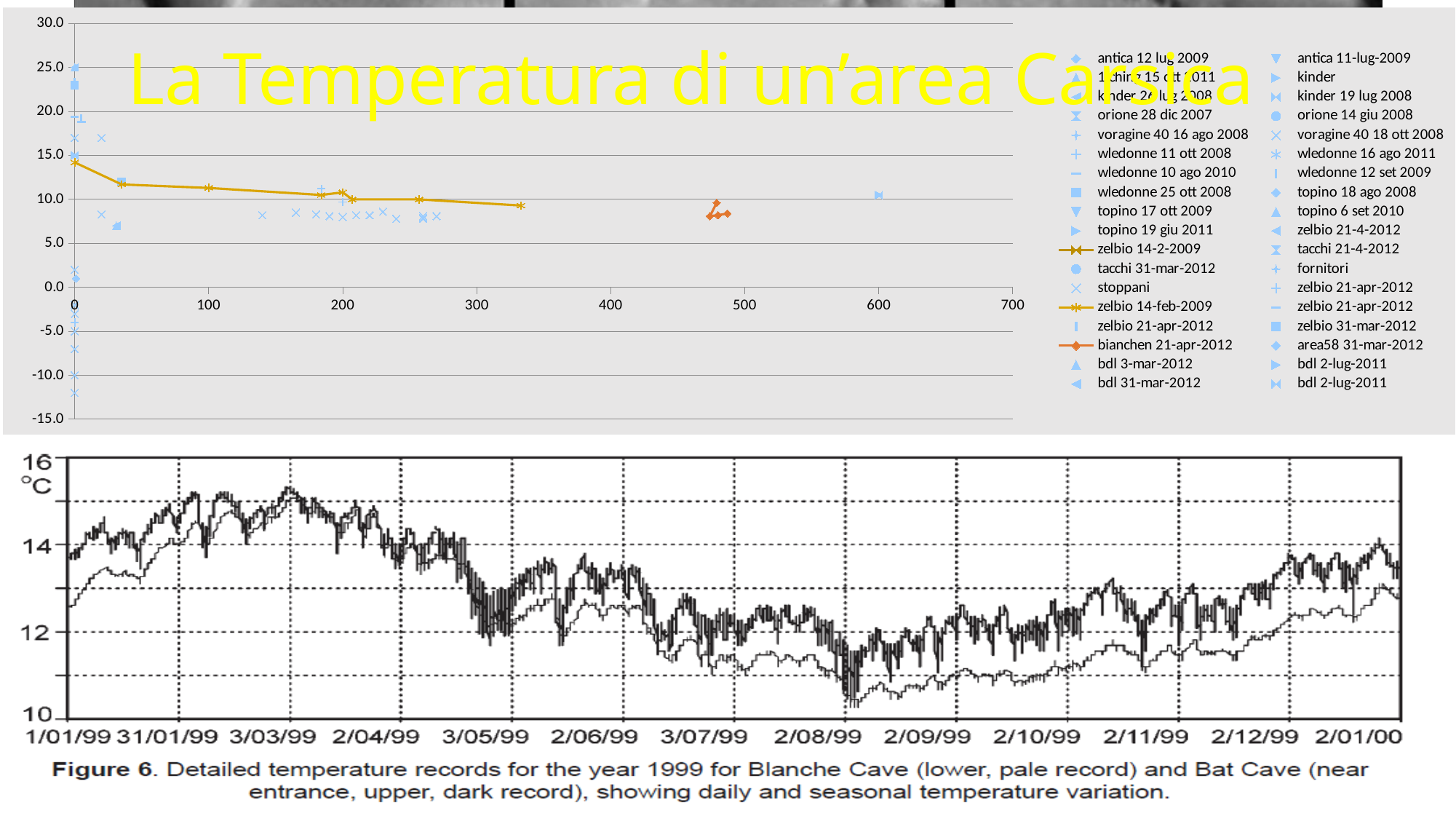
In the top chart, does the orange connected line for zelbio 14-feb-2009 rise or fall as the x value increases? fall In the bottom chart (Figure 6), what unit is shown on the vertical axis? °C In the top chart, are the bianchen 21-apr-2012 points near x = 480 greater or less than 10.0? less In the bottom chart (Figure 6), which cave's record is the upper, dark one? Bat Cave In the top chart, is the value of the orange zelbio 14-feb-2009 line at x = 0 greater or less than 10.0? greater In the top chart, what is the largest value labelled on the horizontal axis? 700 In the bottom chart (Figure 6), is the Bat Cave temperature around 3/03/99 greater or less than 14? greater In the top chart, what is the highest value shown on the vertical axis? 30.0 In the top chart, what kind of chart is it? scatter chart In the bottom chart (Figure 6), do the temperatures rise or fall between 3/03/99 and 2/08/99? fall